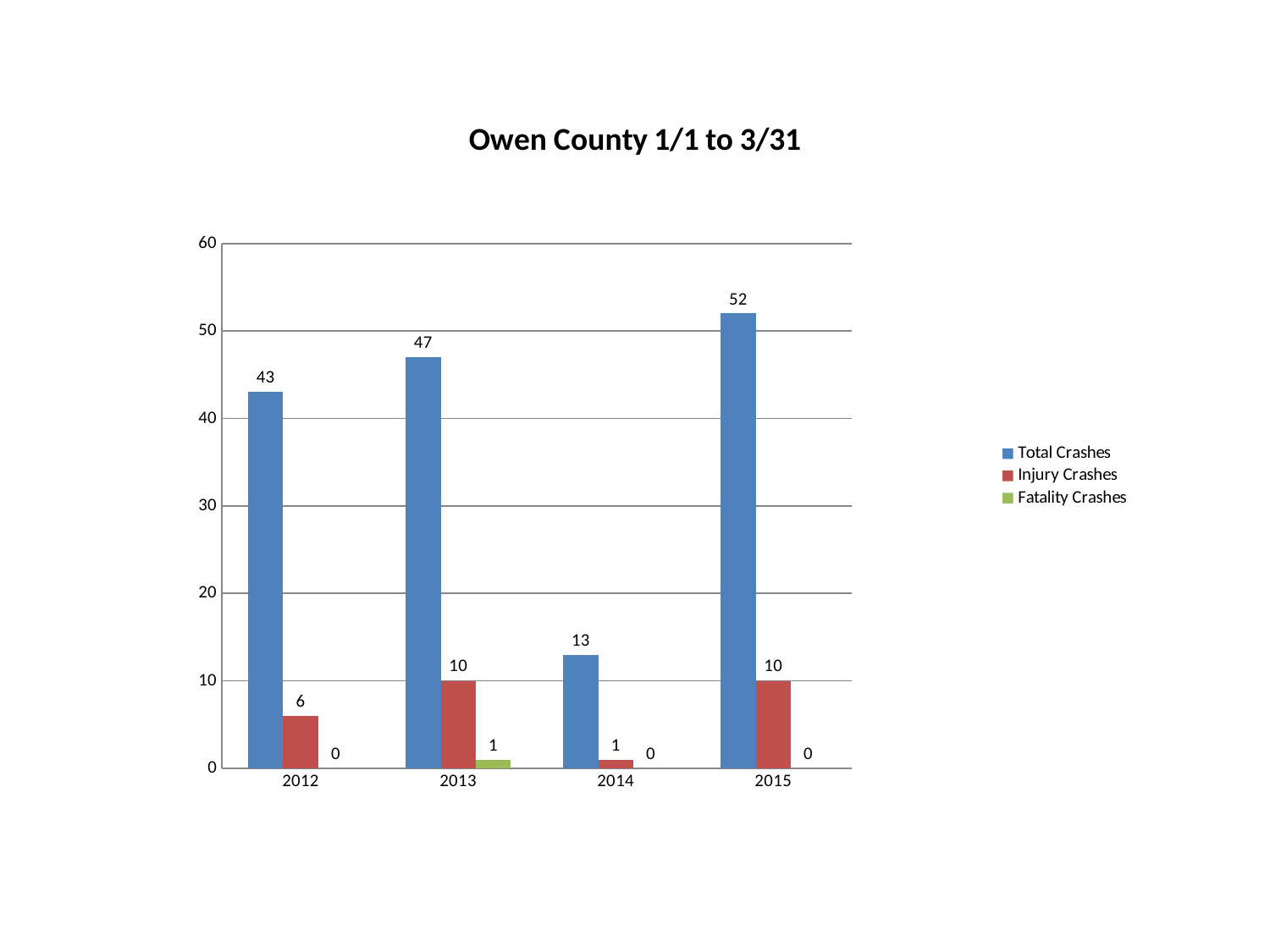
What is the title of the chart? Owen County 1/1 to 3/31 How many series does the legend list? 3 What is the value of Injury Crashes for 2012? 6 What is the value of Total Crashes for 2015? 52 Which year has the highest Total Crashes? 2015 Which is larger, Total Crashes in 2012 or Total Crashes in 2013? 2013 What is the value of Fatality Crashes for 2013? 1 What kind of chart is shown? bar chart How many years are shown on the x axis? 4 What is the difference between Total Crashes in 2015 and 2014? 39 Is the value of Total Crashes for 2013 greater or less than 40? greater Which year has the lowest Total Crashes? 2014